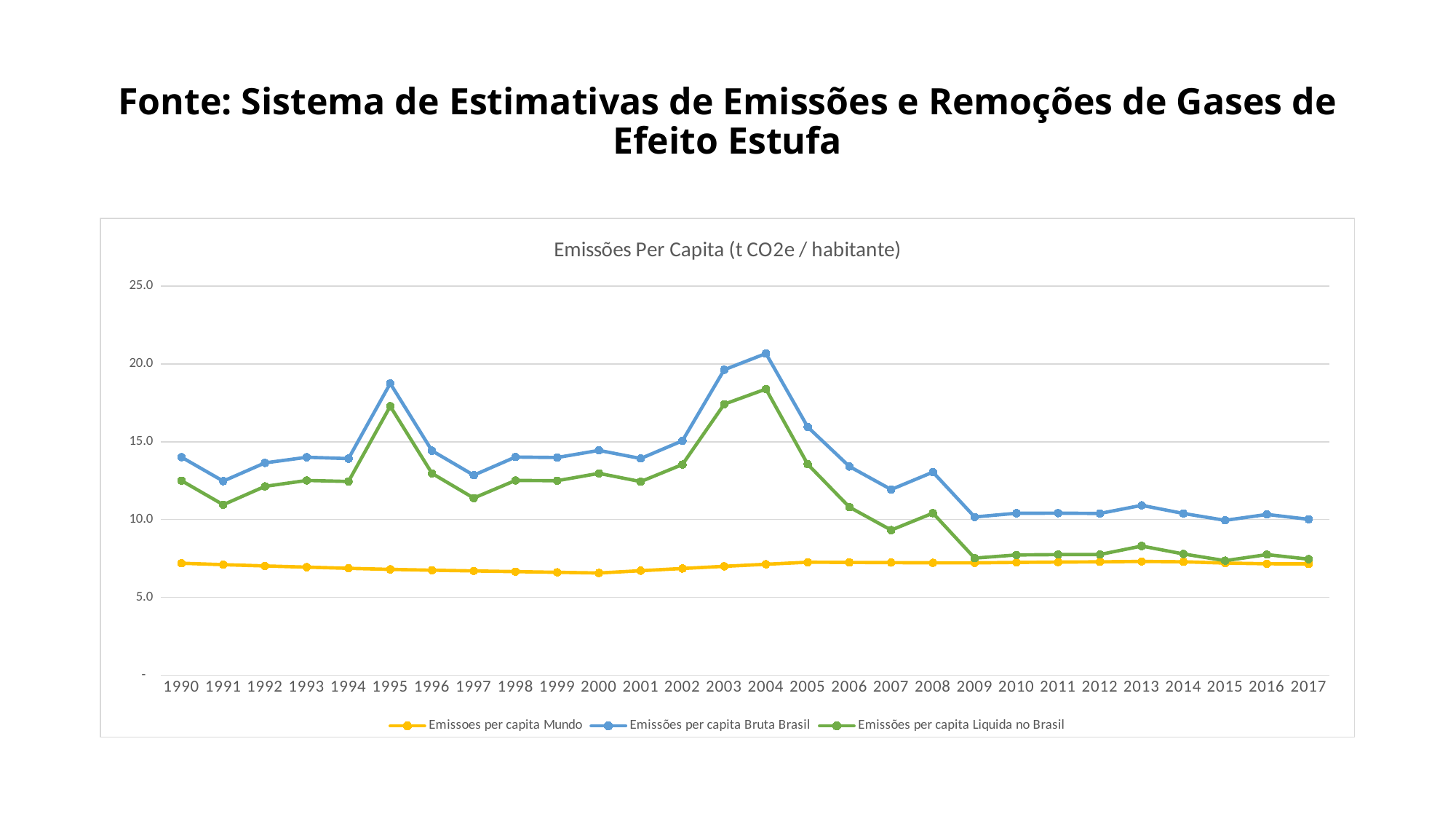
Is the value for Emissoes per capita Mundo in 2000 greater or less than 10.0? less Which is larger in 2003: Emissões per capita Bruta Brasil or Emissoes per capita Mundo? Emissões per capita Bruta Brasil In which year does the Emissões per capita Bruta Brasil series reach its highest value? 2004 How many series does the legend list? 3 In which year does the Emissões per capita Liquida no Brasil series reach its highest value? 2004 Is the value for Emissões per capita Liquida no Brasil in 2007 greater or less than 10.0? less How many years are plotted along the x axis? 28 Does the Emissões per capita Bruta Brasil series rise or fall between 2004 and 2009? fall What is the title of the chart? Emissões Per Capita (t CO2e / habitante) What kind of chart is shown on the slide? line chart Is the value for Emissões per capita Bruta Brasil in 2004 greater or less than 20.0? greater